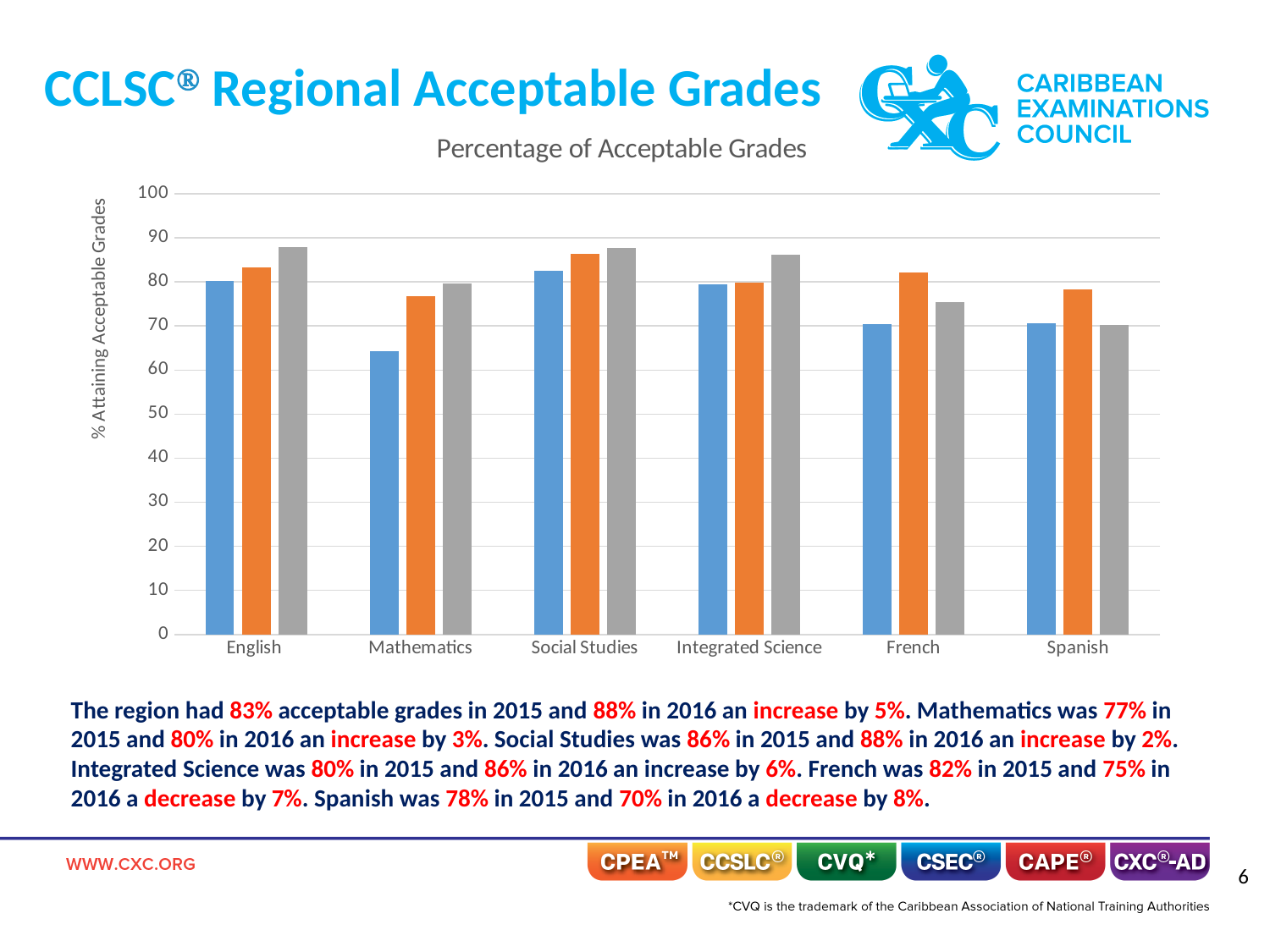
Is the orange bar for Mathematics greater or less than 80? less Is the gray bar for Integrated Science greater or less than 80? greater Which is larger, the gray bar for French or the gray bar for Spanish? French How many bars are plotted for each subject category? 3 Which subject has the highest orange bar? Social Studies What is the label on the vertical axis of the chart? % Attaining Acceptable Grades Which subject has the lowest blue bar? Mathematics Do the three bars for English rise or fall from left to right? rise Is the gray bar for English greater or less than 80? greater How many subject categories are shown on the x axis of the chart? 6 What kind of chart is shown on the slide? Bar chart